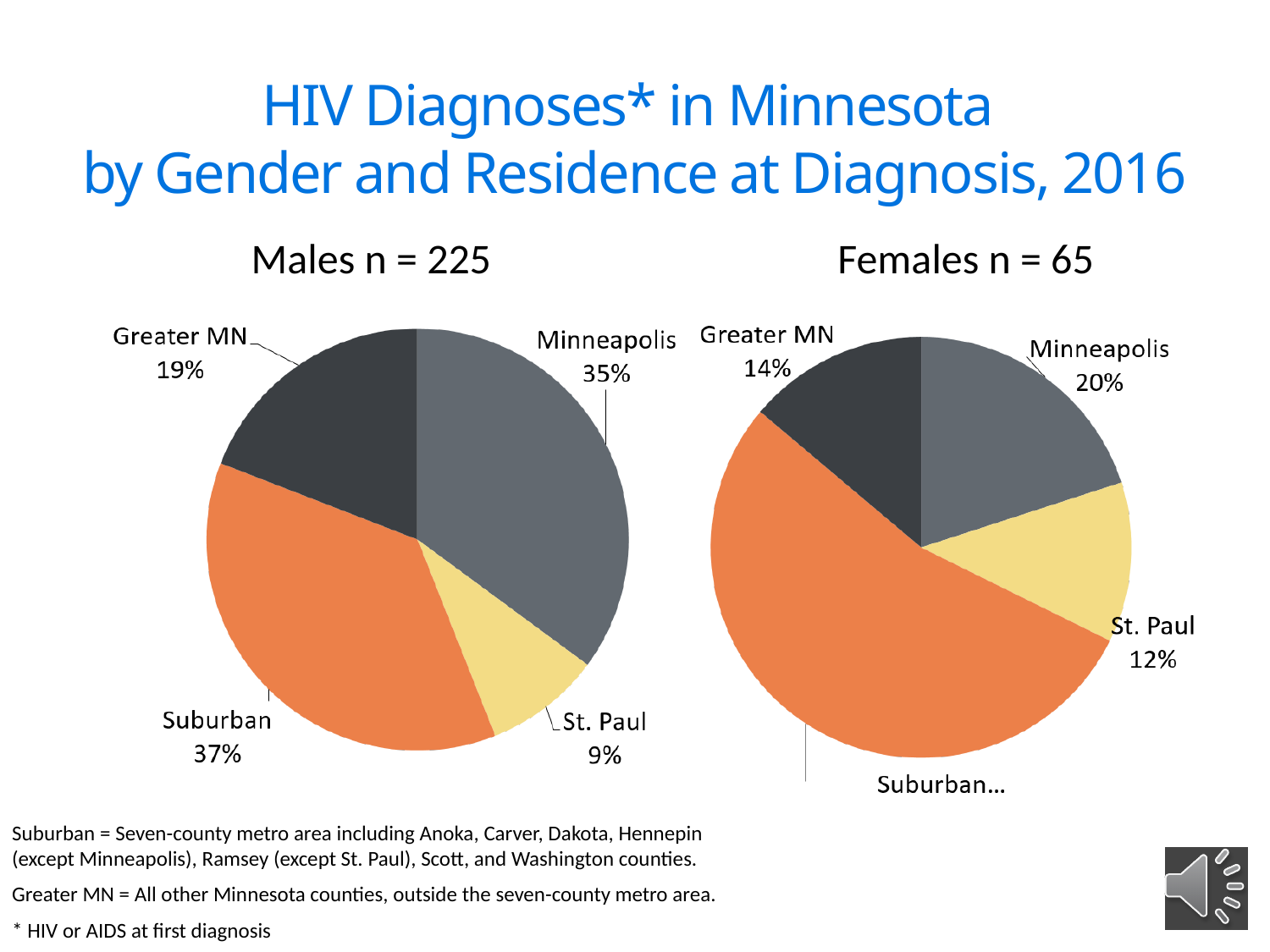
In the Females n = 65 pie chart, what percentage is shown for Greater MN? 14% In the Males n = 225 pie chart, which residence category has the largest share? Suburban In the Females n = 65 pie chart, what percentage is shown for Minneapolis? 20% How many slices does the Males n = 225 pie chart have? 4 In the Females n = 65 pie chart, which residence category has the largest slice? Suburban In the Males n = 225 pie chart, what is the difference in percentage points between Suburban and Greater MN? 18 In the Males n = 225 pie chart, which residence category has the smallest share? St. Paul In the Males n = 225 pie chart, what share is labelled for St. Paul? 9% What is the sample size shown in the title of the Females pie chart? 65 What type of chart is used on this slide to show residence at diagnosis? Pie chart In the Males n = 225 pie chart, what percentage of HIV diagnoses were in Minneapolis? 35% Which is larger in the Females n = 65 pie chart: the Minneapolis share or the St. Paul share? Minneapolis